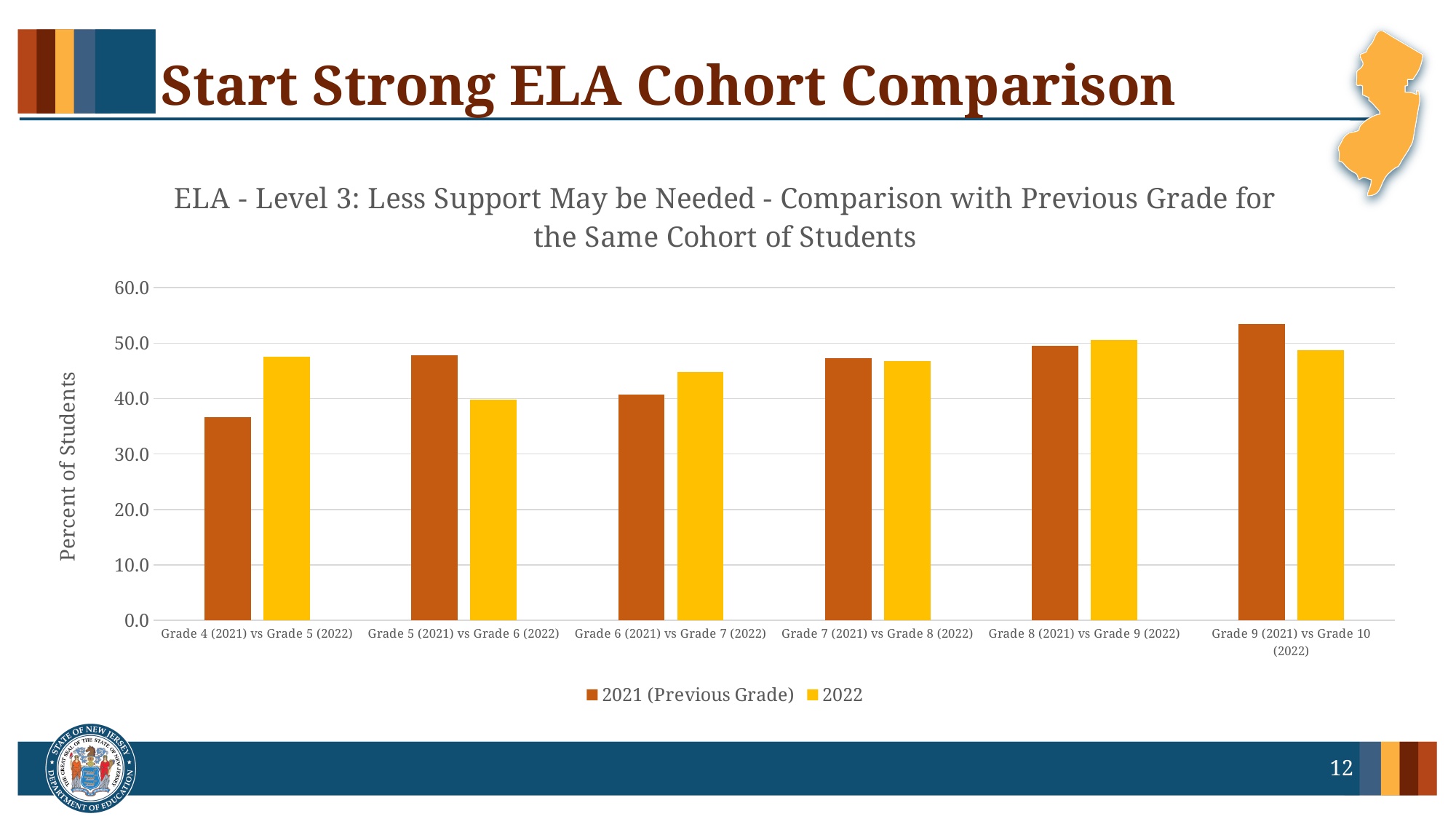
Is the 2021 (Previous Grade) value for Grade 4 (2021) vs Grade 5 (2022) greater or less than 40.0? less Is the 2021 (Previous Grade) value for Grade 9 (2021) vs Grade 10 (2022) greater or less than 50.0? greater How many grade-comparison categories are shown on the x axis? 6 Is the 2022 value for Grade 6 (2021) vs Grade 7 (2022) greater or less than 40.0? greater What is the label on the vertical axis of the chart? Percent of Students For Grade 4 (2021) vs Grade 5 (2022), which series has the larger value, 2021 (Previous Grade) or 2022? 2022 For Grade 5 (2021) vs Grade 6 (2022), which series has the larger value, 2021 (Previous Grade) or 2022? 2021 (Previous Grade) Which category has the highest value for the 2021 (Previous Grade) series? Grade 9 (2021) vs Grade 10 (2022) What kind of chart is shown on the slide? bar chart Which category has the lowest value for the 2021 (Previous Grade) series? Grade 4 (2021) vs Grade 5 (2022) How many series does the legend list? 2 Which category has the lowest value for the 2022 series? Grade 5 (2021) vs Grade 6 (2022)